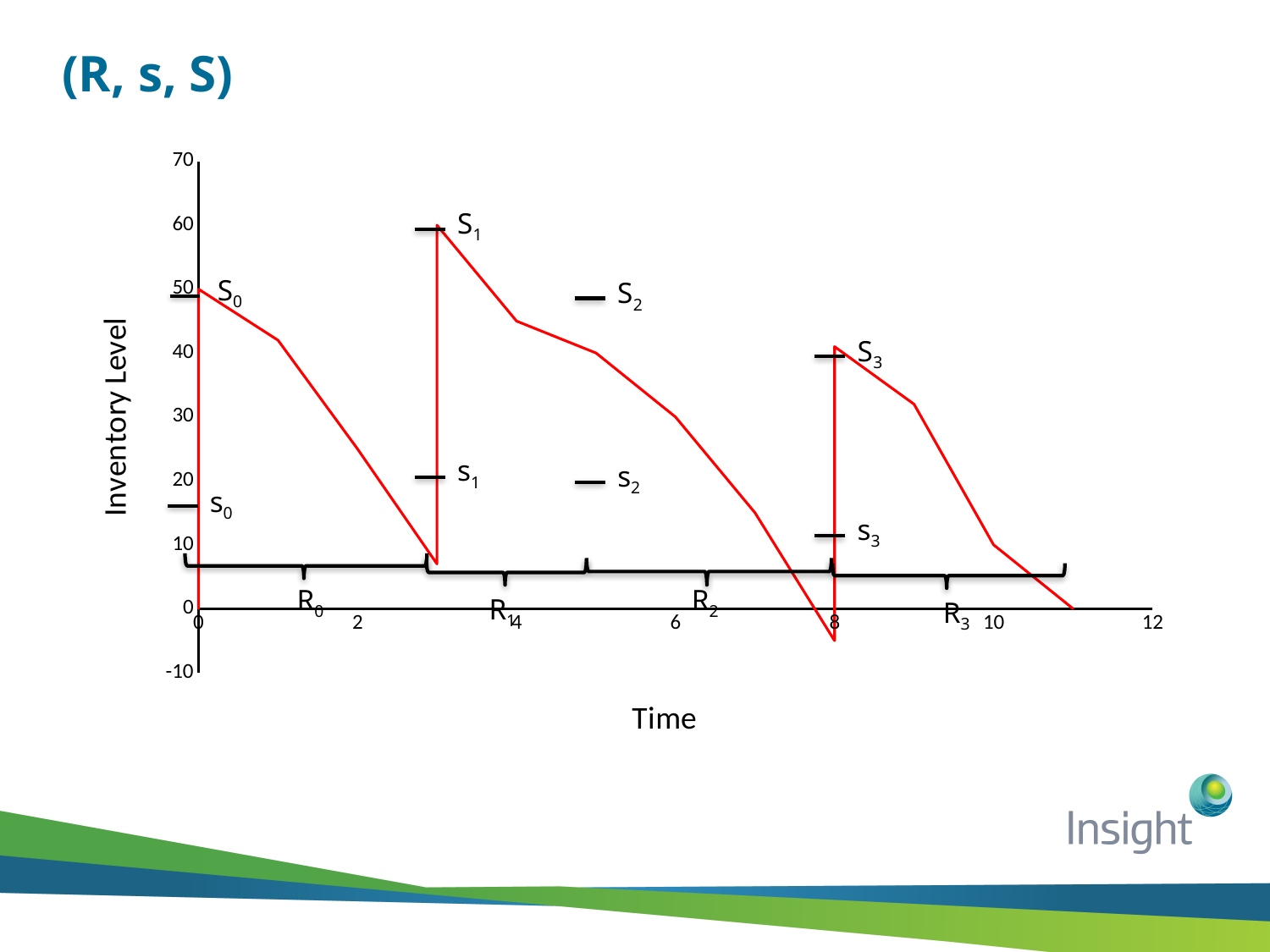
What is the label of the vertical axis? Inventory Level How many review periods (R0, R1, R2, R3) are marked along the time axis? 4 Is the order-up-to level S2 greater or less than 60? less Which of the order-up-to levels S0, S1, S2 and S3 is the lowest? S3 Which is higher, the order-up-to level S1 or S3? S1 What is the title of the slide's chart? (R, s, S) Is the order-up-to level S3 greater or less than 50? less Is the order-up-to level S1 greater or less than 50? greater What kind of chart is shown on the slide? line chart Which of the order-up-to levels S0, S1, S2 and S3 is the highest? S1